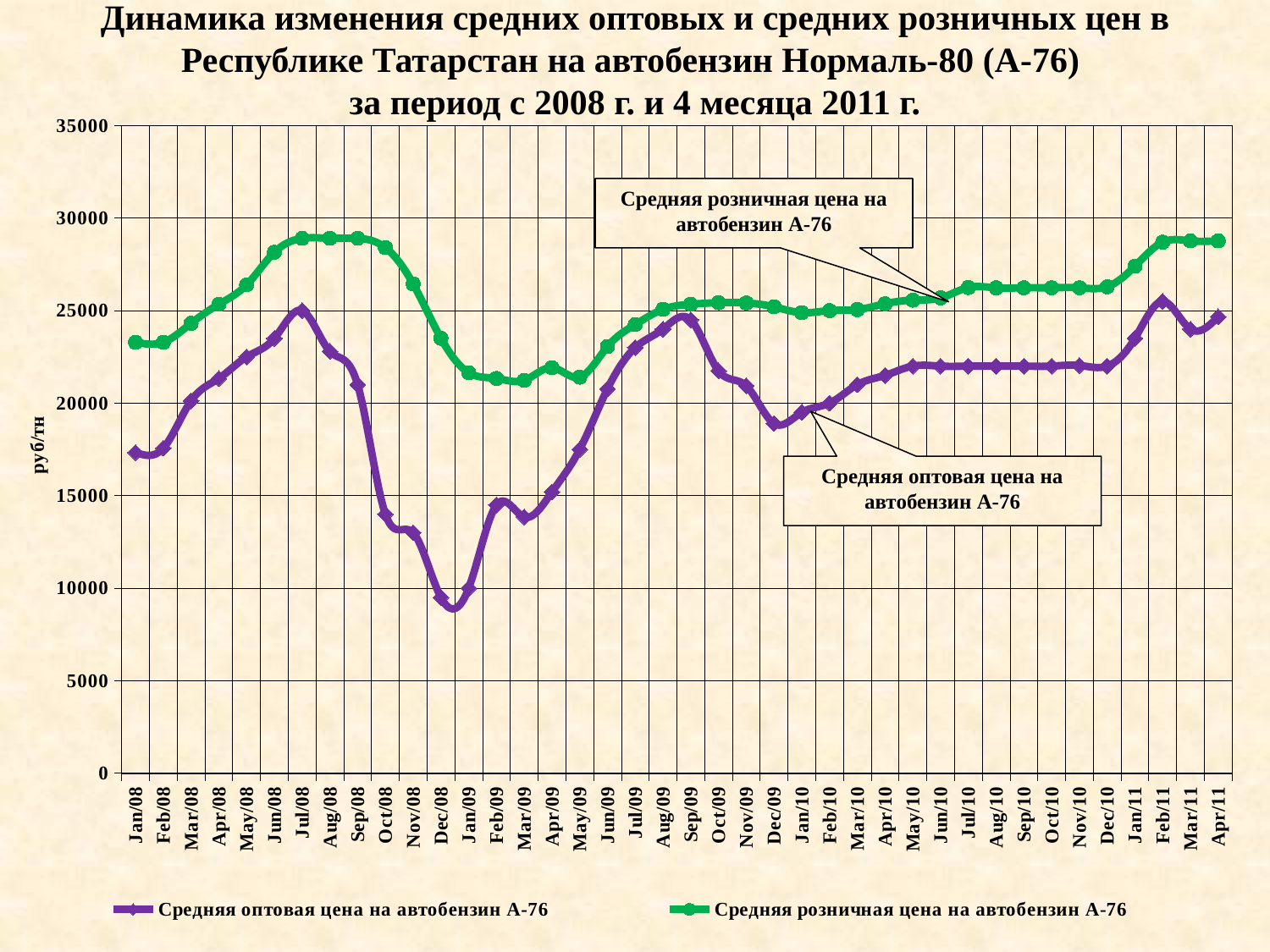
Is the value of Средняя оптовая цена на автобензин А-76 in Jan/08 greater or less than 20000? less Does Средняя розничная цена на автобензин А-76 rise or fall from Jan/08 to Jul/08? rise Is the value of Средняя розничная цена на автобензин А-76 in Apr/11 greater or less than 25000? greater How many months are plotted along the x axis? 40 In Dec/08, which is larger: the Средняя оптовая цена or the Средняя розничная цена на автобензин А-76? Средняя розничная цена на автобензин А-76 Is the value of Средняя оптовая цена на автобензин А-76 in Dec/08 greater or less than 10000? less In which month does Средняя оптовая цена на автобензин А-76 reach its lowest value? Dec/08 What kind of chart is shown on the slide? line chart Does Средняя оптовая цена на автобензин А-76 rise or fall from Jul/08 to Dec/08? fall How many series does the legend list? 2 What is the label on the vertical axis? руб/тн